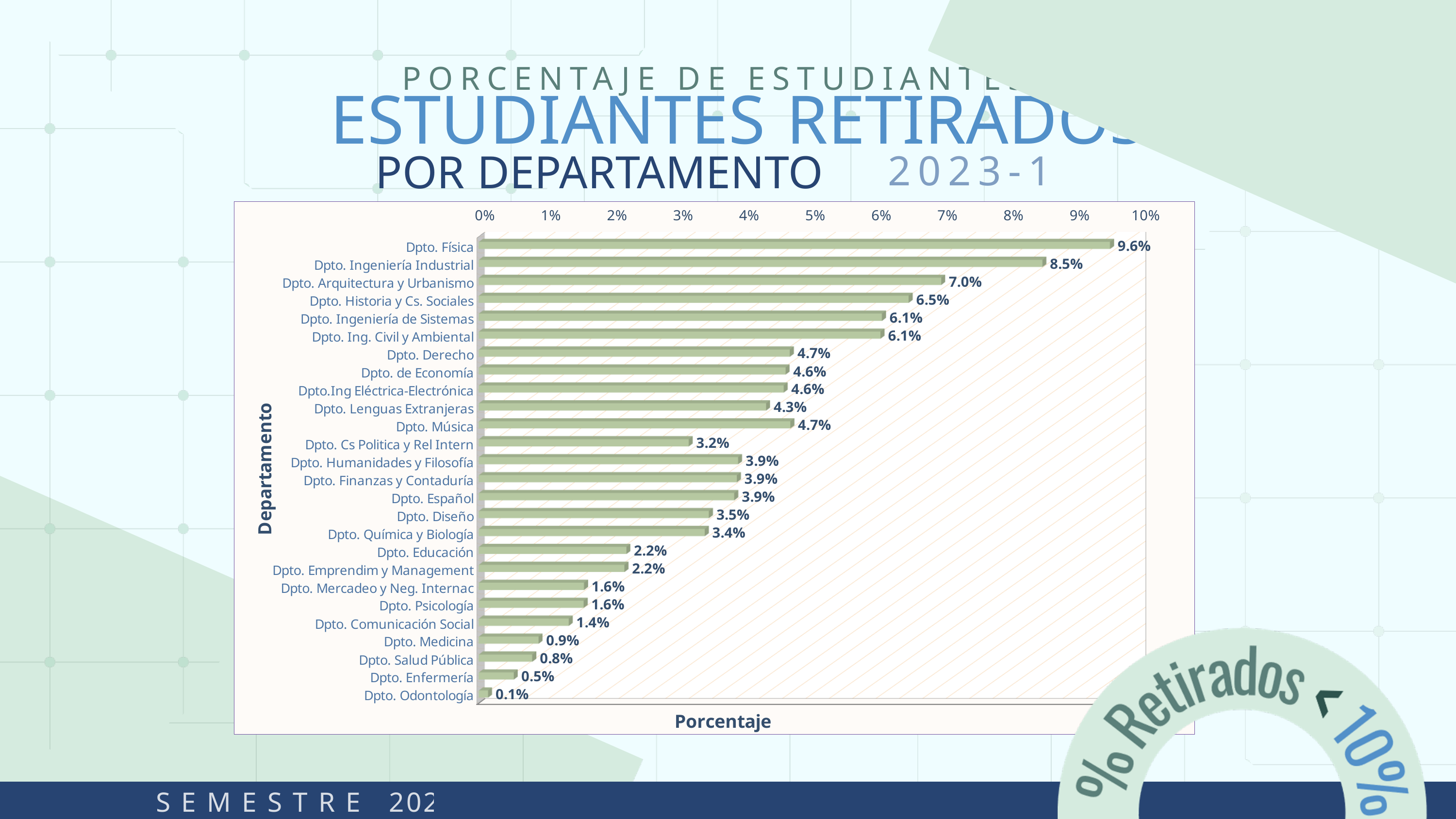
Which department has the lowest percentage? Dpto. Odontología What is the difference between Dpto. Física and Dpto. Ingeniería Industrial? 1.1% What is the value for Dpto. Odontología? 0.1% How many departments are shown in the chart? 26 What is the label of the horizontal axis? Porcentaje What is the value for Dpto. Física? 9.6% Which department has the highest percentage? Dpto. Física Is the value for Dpto. Lenguas Extranjeras greater or less than 5%? less What is the value for Dpto. Química y Biología? 3.4% What kind of chart is shown on the slide? bar chart Which is larger, the value for Dpto. Arquitectura y Urbanismo or Dpto. Historia y Cs. Sociales? Dpto. Arquitectura y Urbanismo What is the value for Dpto. Derecho? 4.7%